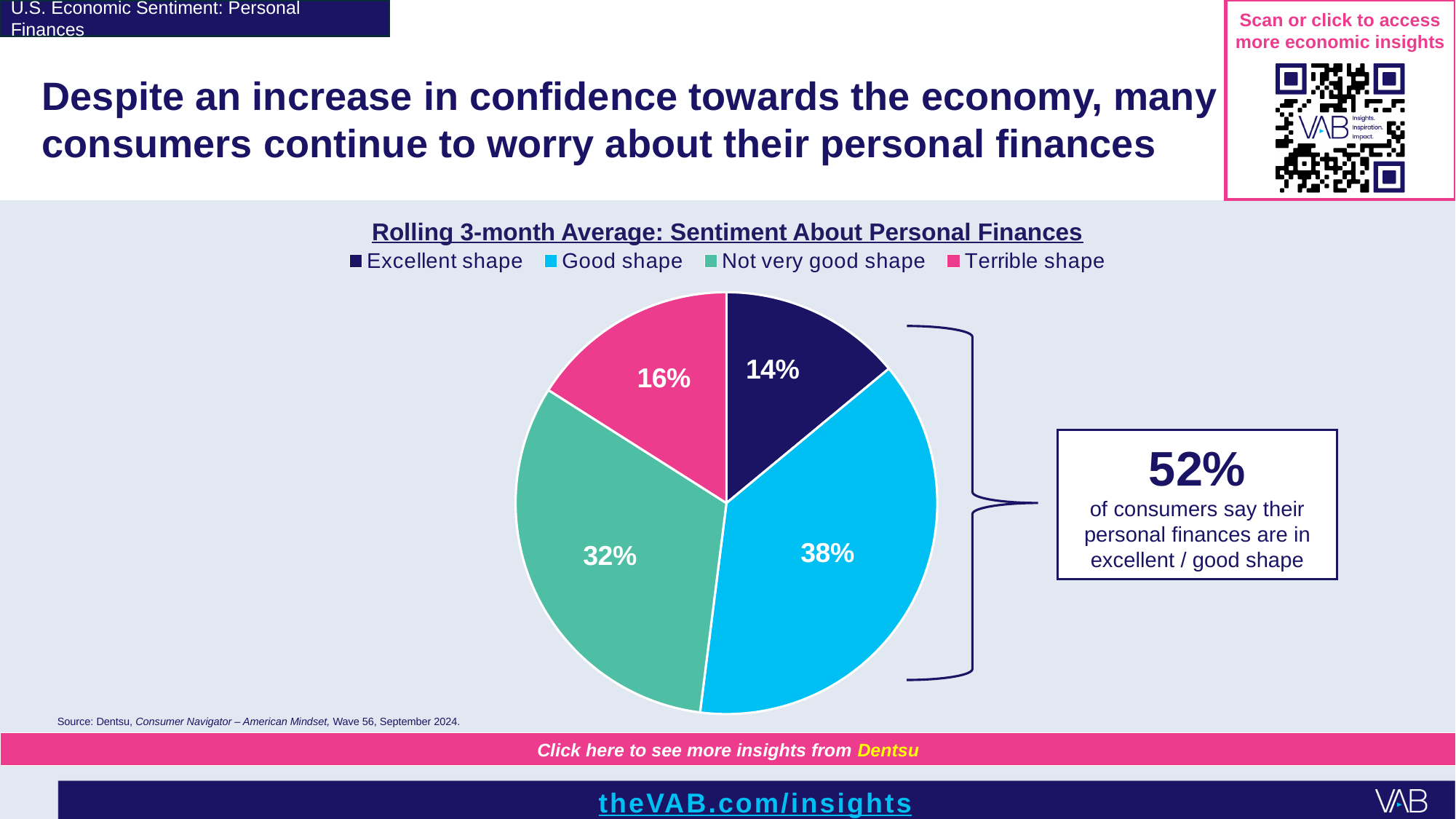
What percentage of consumers say their personal finances are in Terrible shape? 16% What kind of chart is shown on the slide? Pie chart What is the title of the chart? Rolling 3-month Average: Sentiment About Personal Finances What percentage of consumers say their personal finances are in Excellent shape? 14% Which is larger, the share for Terrible shape or the share for Excellent shape? Terrible shape What is the combined share of Excellent shape and Good shape? 52% What percentage of consumers say their personal finances are in Not very good shape? 32% What percentage of consumers say their personal finances are in Good shape? 38% What is the difference in percentage points between Good shape and Not very good shape? 6 Which category has the smallest share of the pie? Excellent shape Which category has the largest share of the pie? Good shape How many categories does the legend list? 4